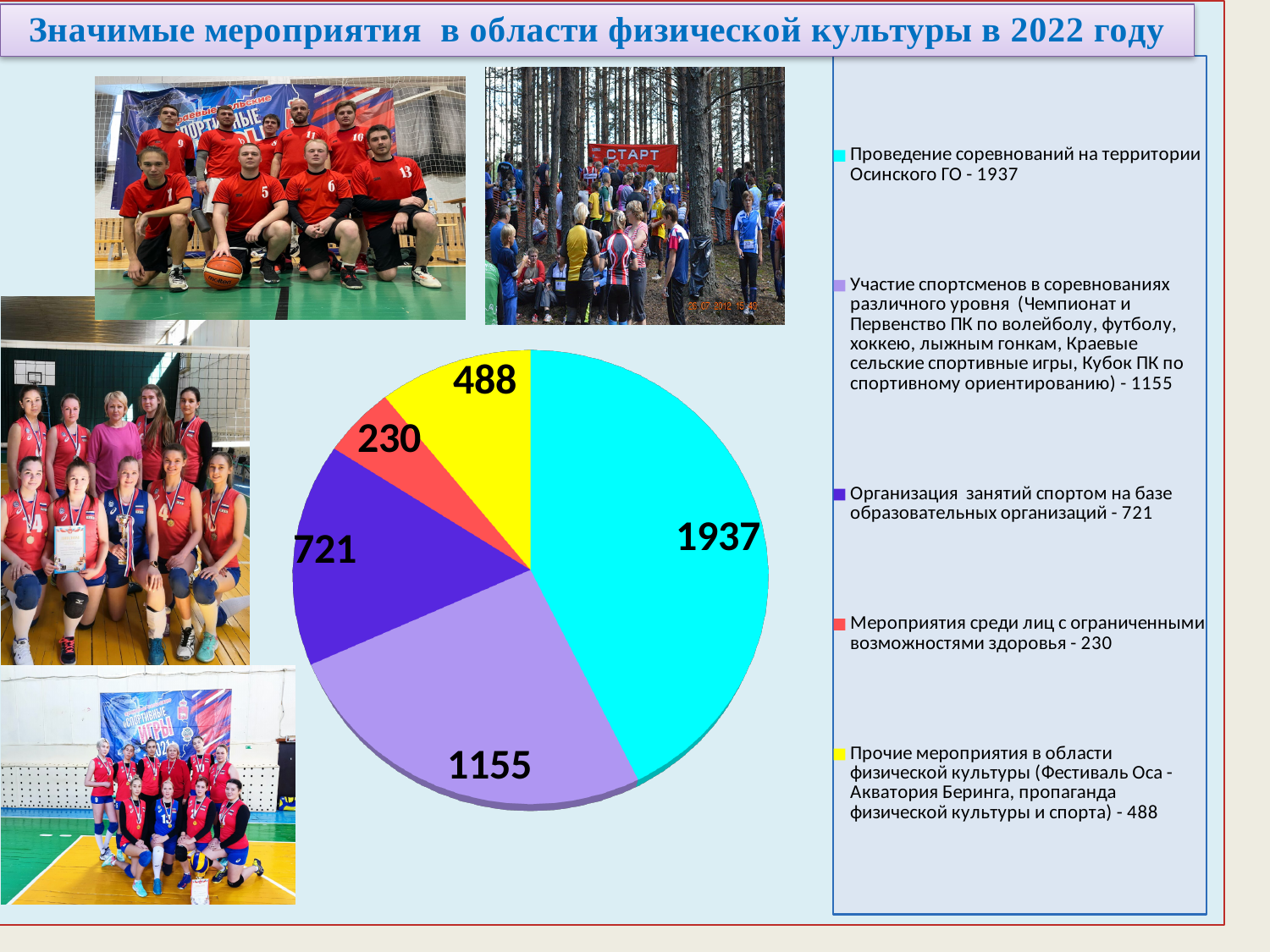
What is the value for "Организация занятий спортом на базе образовательных организаций"? 721 Which category has the largest slice of the pie? Проведение соревнований на территории Осинского ГО What colour is the slice representing 1937? cyan What is the difference between the largest slice (1937) and the slice for "Участие спортсменов в соревнованиях различного уровня" (1155)? 782 How many entries does the legend of the pie chart list? 5 What is the value for "Мероприятия среди лиц с ограниченными возможностями здоровья"? 230 What type of chart is shown on the slide? pie chart What is the value for "Прочие мероприятия в области физической культуры"? 488 How many slices does the pie chart have? 5 What is the value for "Проведение соревнований на территории Осинского ГО"? 1937 Which is larger: the slice for "Прочие мероприятия в области физической культуры" or the slice for "Организация занятий спортом на базе образовательных организаций"? Организация занятий спортом на базе образовательных организаций Which category has the smallest slice of the pie? Мероприятия среди лиц с ограниченными возможностями здоровья